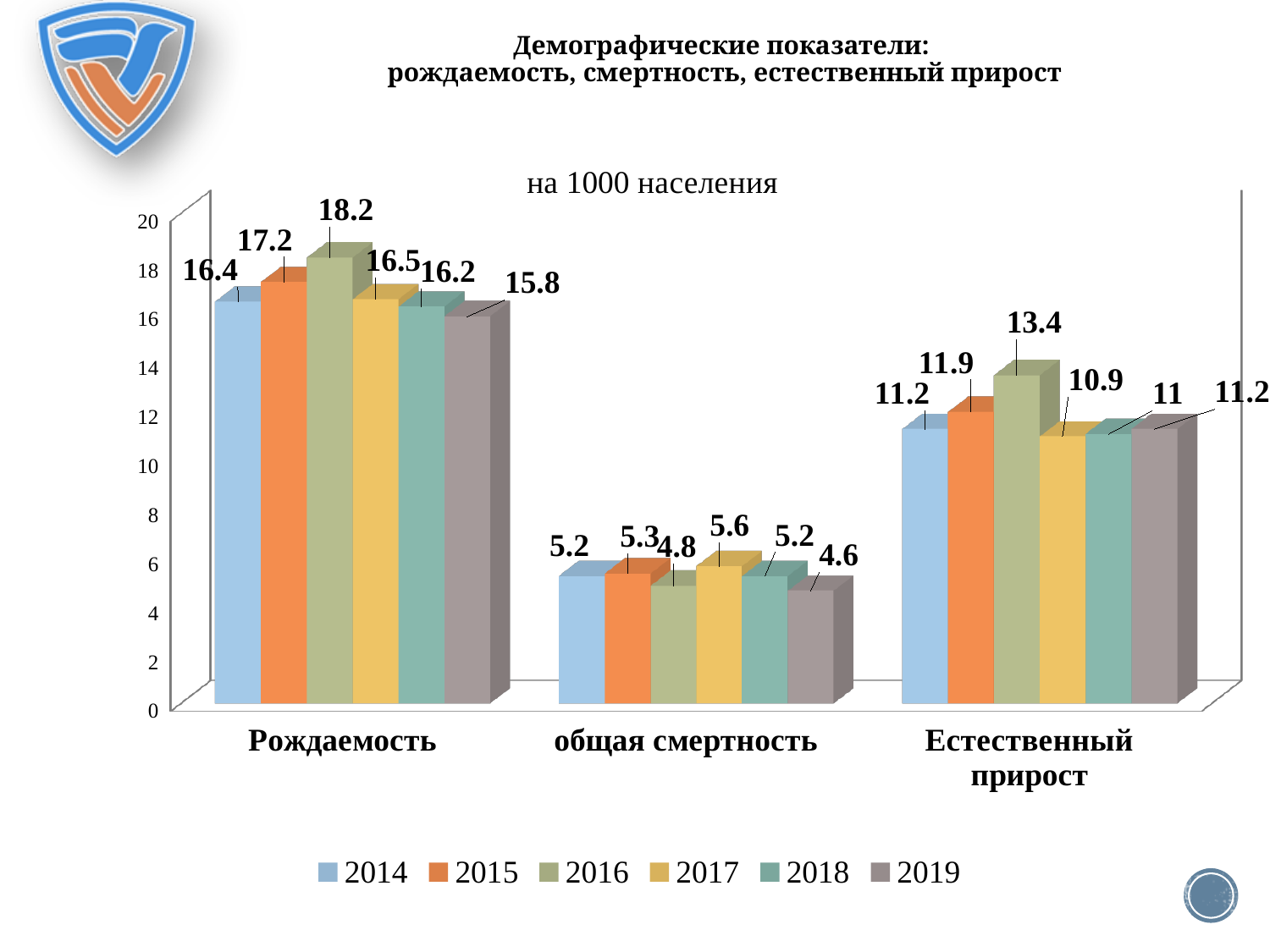
Which year has the lowest value for общая смертность? 2019 What is the difference between the Рождаемость values for 2016 and 2019? 2.4 How many series does the legend list? 6 What is the value for Рождаемость in 2016? 18.2 Which year has the highest value for Рождаемость? 2016 What is the value for общая смертность in 2019? 4.6 What kind of chart is shown on the slide? bar chart What is the value for Естественный прирост in 2017? 10.9 What is the chart's title? на 1000 населения How many categories are shown on the x axis? 3 Which legend entry is shown in orange? 2015 Which is larger: Естественный прирост in 2015 or in 2017? 2015